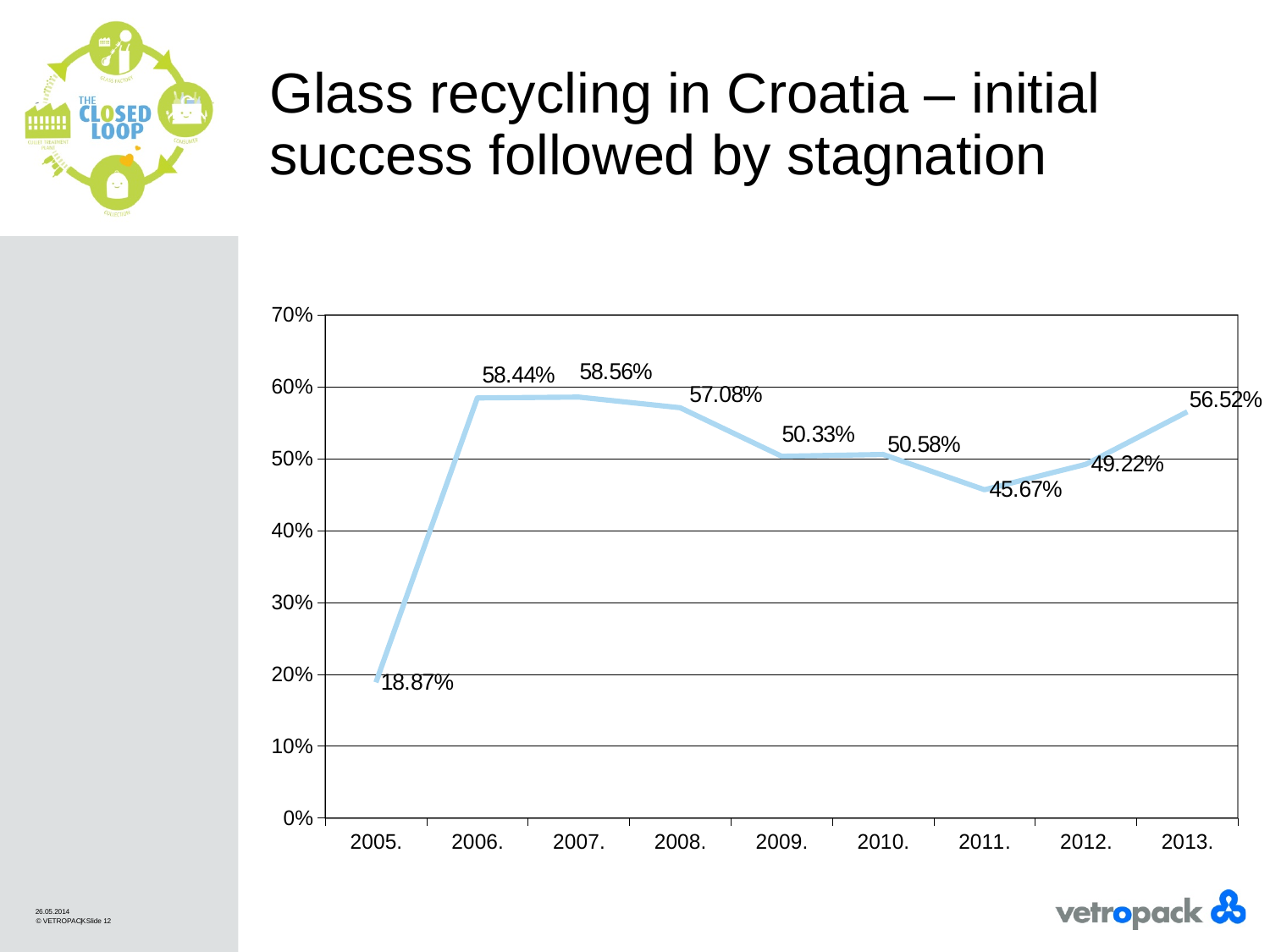
What is the glass recycling rate shown for 2005? 18.87% Do the values rise or fall from 2011 to 2013? rise What is the difference between the values for 2006 and 2005? 39.57% What kind of chart is shown on the slide? line chart What value is shown for 2011? 45.67% What value is shown for 2013? 56.52% Is the value for 2010 greater or less than 40%? greater Which is larger, the value for 2008 or the value for 2012? 2008. What is the highest value labelled on the y axis? 70% How many years are plotted on the x axis? 9 Which year has the highest value on the chart? 2007. Which year has the lowest value on the chart? 2005.